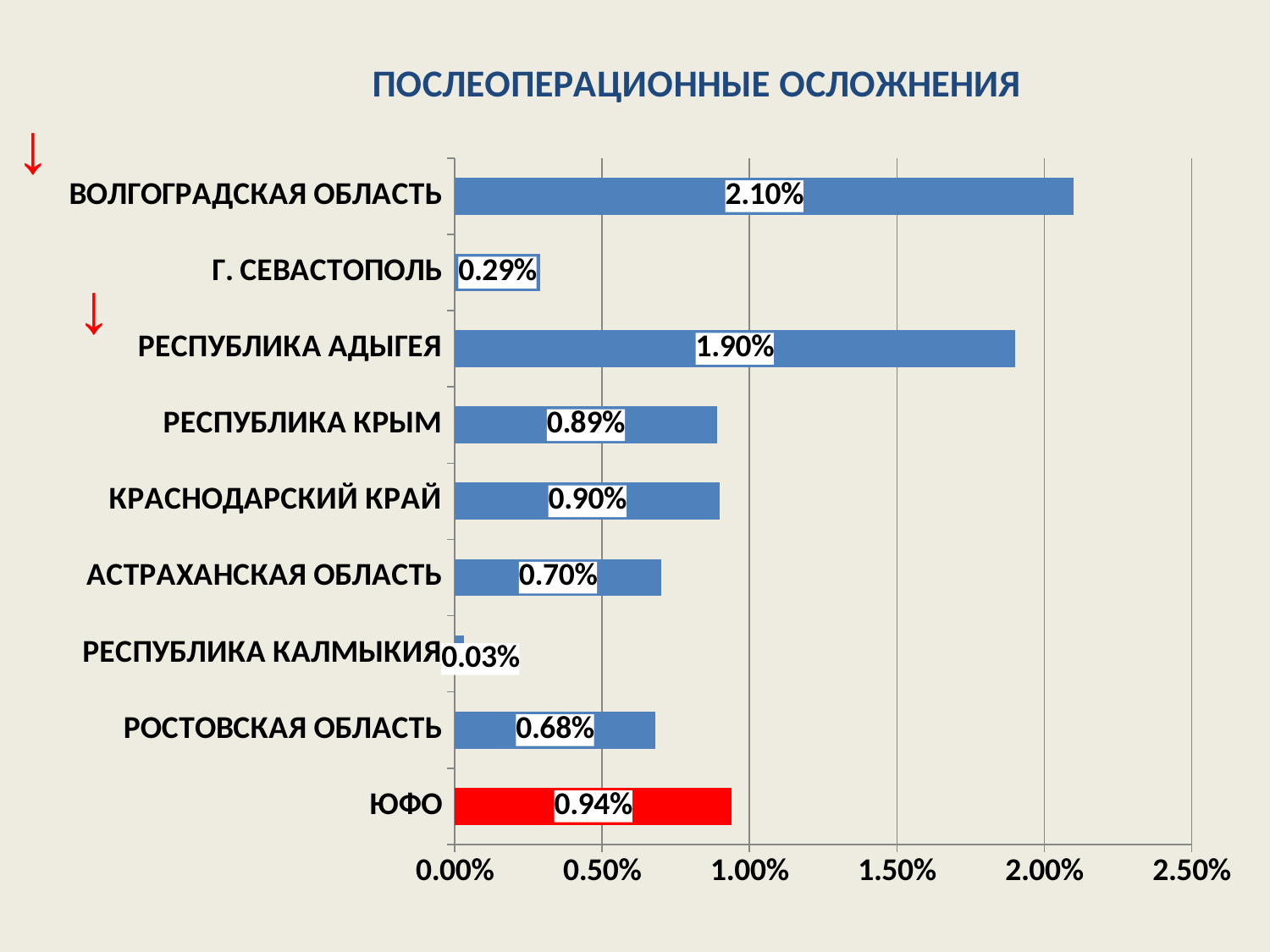
Which category has the highest value? Волгоградская область What is the value for Республика Адыгея? 1.90% What is the title of the chart? ПОСЛЕОПЕРАЦИОННЫЕ ОСЛОЖНЕНИЯ What kind of chart is shown on the slide? bar chart How many categories are shown in the chart? 9 Which category has the lowest value? Республика Калмыкия What is the value for ЮФО? 0.94% Is the value for Республика Крым greater or less than 1.00%? less What is the value for Волгоградская область? 2.10% Which is larger, the value for Астраханская область or the value for Ростовская область? Астраханская область What is the value for Республика Калмыкия? 0.03% What is the difference between the values for Волгоградская область and Республика Адыгея? 0.20%